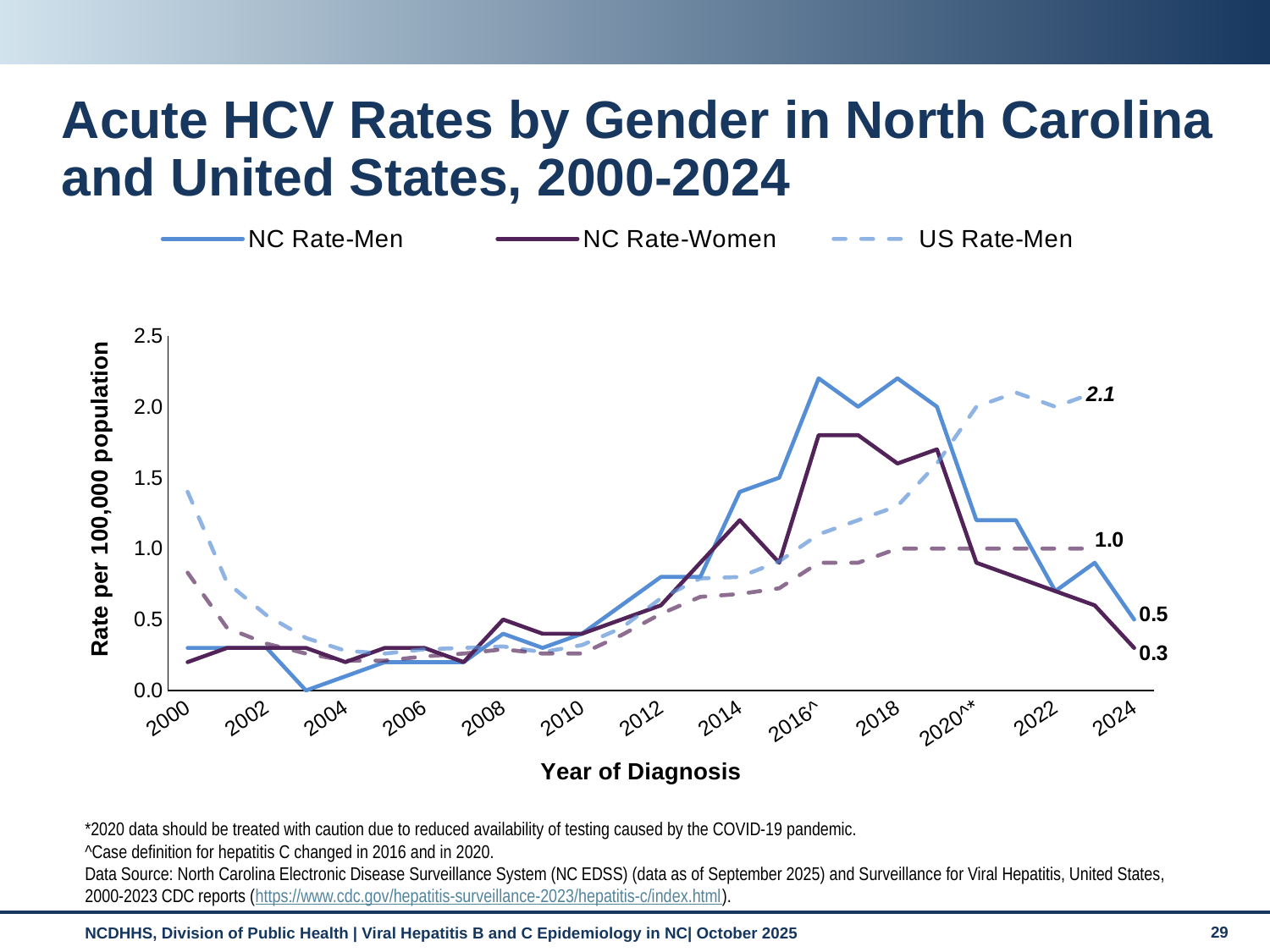
How many series does the legend list? 3 Does the NC Rate-Men line rise or fall from 2020 to 2024? fall In 2024, which is larger: NC Rate-Men or NC Rate-Women? NC Rate-Men Is the US Rate-Men value in 2000 greater or less than 1.0? greater What is the title of the y axis? Rate per 100,000 population What kind of chart is shown on the slide? line chart Is the NC Rate-Men value in 2004 greater or less than 0.5? less What is the NC Rate-Men value in 2024? 0.5 What is the difference between the NC Rate-Men and NC Rate-Women values in 2024? 0.2 What is the NC Rate-Women value in 2024? 0.3 What is the labelled value at the end of the US Rate-Men line? 2.1